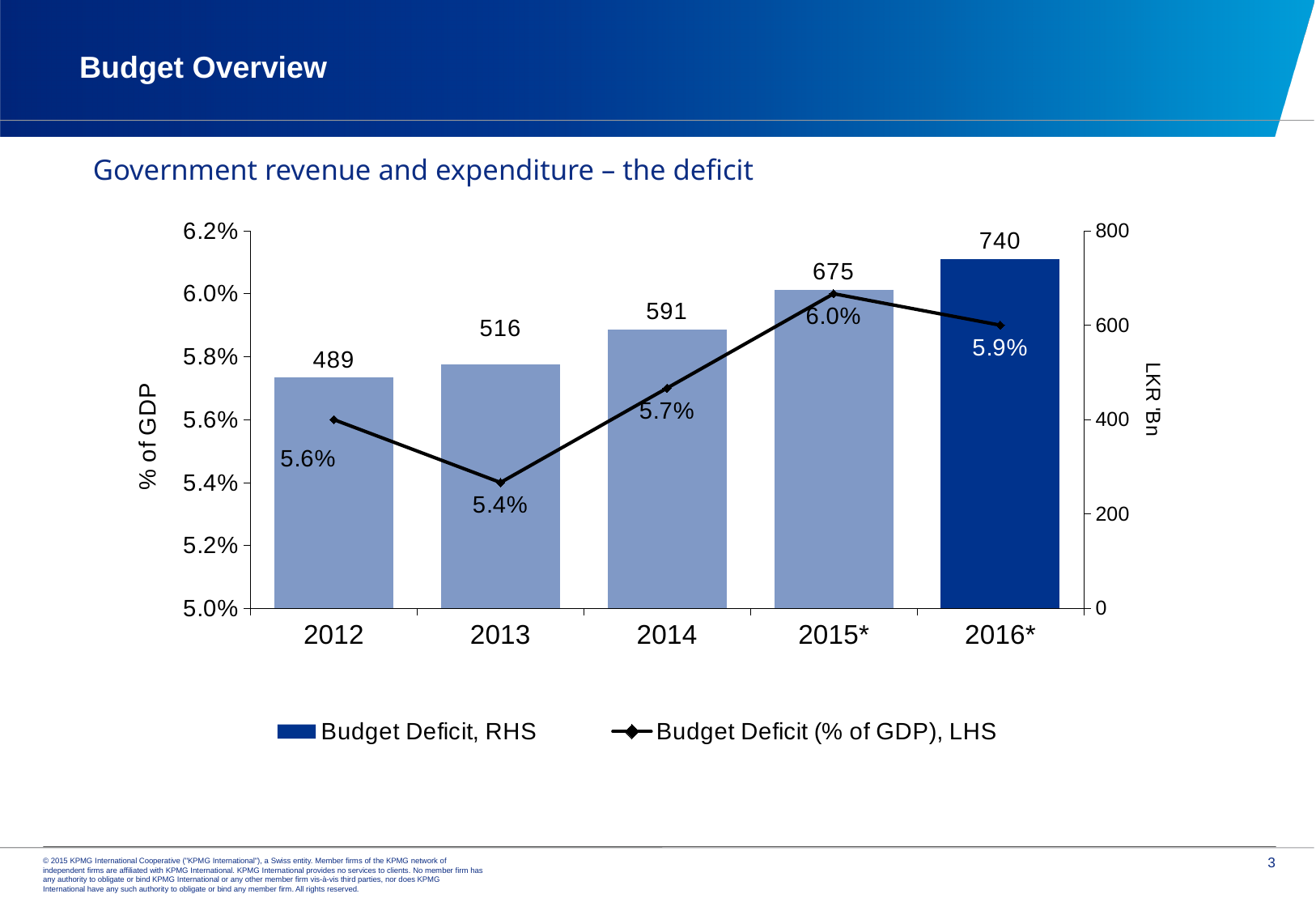
Which year has the lowest Budget Deficit as % of GDP? 2013 What is the title of the chart? Government revenue and expenditure – the deficit Is the Budget Deficit (LKR 'Bn) for 2013 greater or less than 600? less Which is larger, the Budget Deficit (% of GDP) in 2015* or in 2016*? 2015* Which year has the highest Budget Deficit in LKR 'Bn? 2016* What is the Budget Deficit as % of GDP for 2013? 5.4% What is the difference in Budget Deficit (LKR 'Bn) between 2016* and 2012? 251 How many series does the legend list? 2 How many years are shown on the x axis? 5 What kind of chart is this? Combined bar and line chart What is the Budget Deficit (LKR 'Bn) for 2014? 591 What is the Budget Deficit (LKR 'Bn) for 2016*? 740